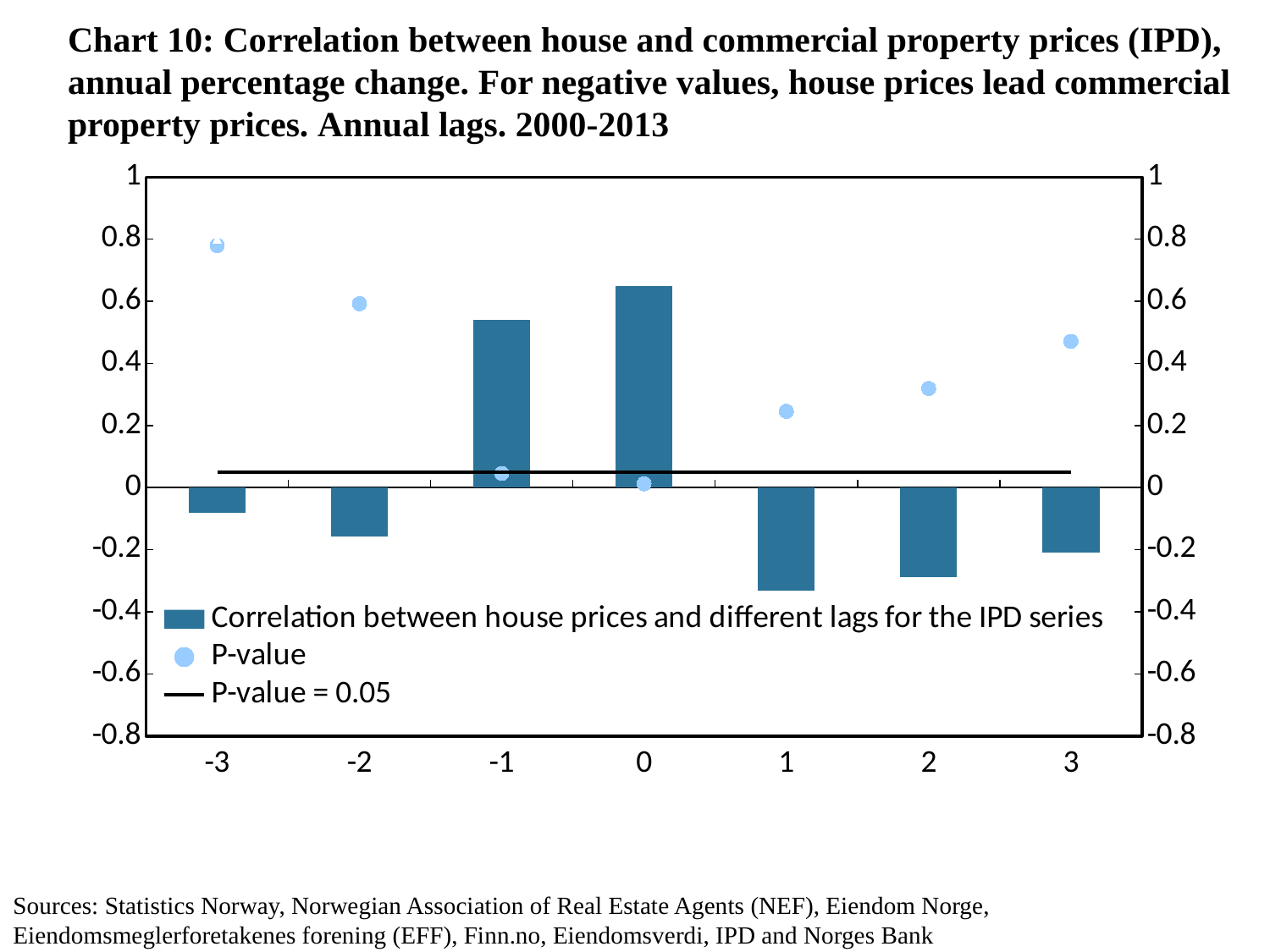
Is the P-value at lag 3 greater or less than 0.4? greater Is the correlation value at lag 1 greater or less than -0.2? less How many series does the legend list? 3 At which lag is the P-value highest? -3 What P-value does the horizontal black line in the legend represent? 0.05 Which is larger, the P-value at lag -2 or at lag 2? lag -2 At which lag is the correlation bar lowest? 1 Is the correlation value at lag 0 greater or less than 0.6? greater At which lag is the correlation bar highest? 0 Which is larger, the correlation bar at lag -1 or at lag -2? lag -1 How many lag categories are shown on the x axis? 7 What kind of chart is shown on the slide? bar chart